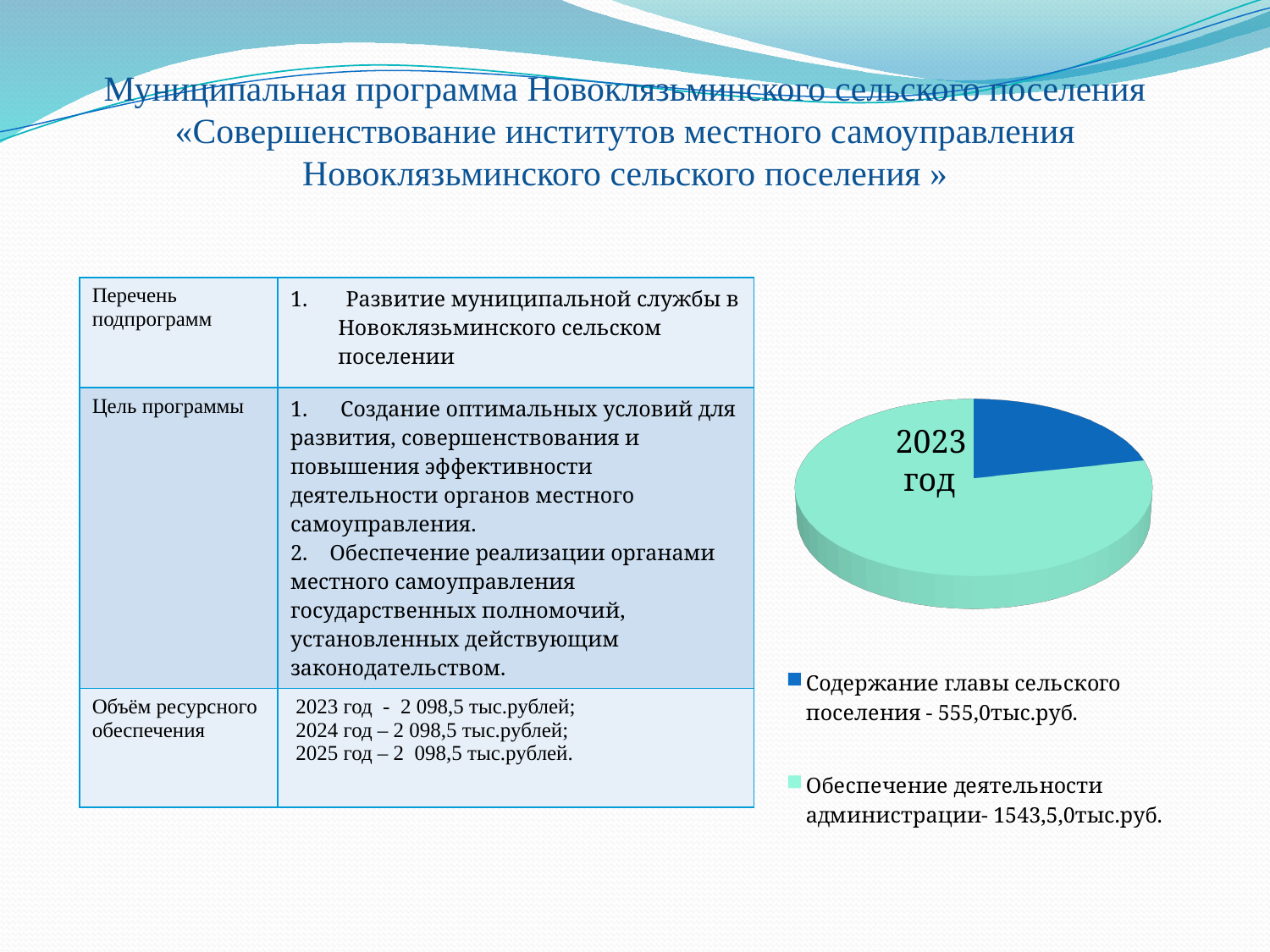
How many entries does the legend of the pie chart list? 2 What kind of chart is shown on the slide? pie chart How many slices does the pie chart have? 2 What year label is printed on the pie chart? 2023 год What value does the legend give for Содержание главы сельского поселения? 555,0тыс.руб. Which is larger in the pie chart: Содержание главы сельского поселения or Обеспечение деятельности администрации? Обеспечение деятельности администрации What colour is the slice for Содержание главы сельского поселения in the pie chart? dark blue What value does the legend give for Обеспечение деятельности администрации? 1543,5,0тыс.руб. Which category takes the smallest share of the pie chart? Содержание главы сельского поселения Which category takes the largest share of the pie chart? Обеспечение деятельности администрации